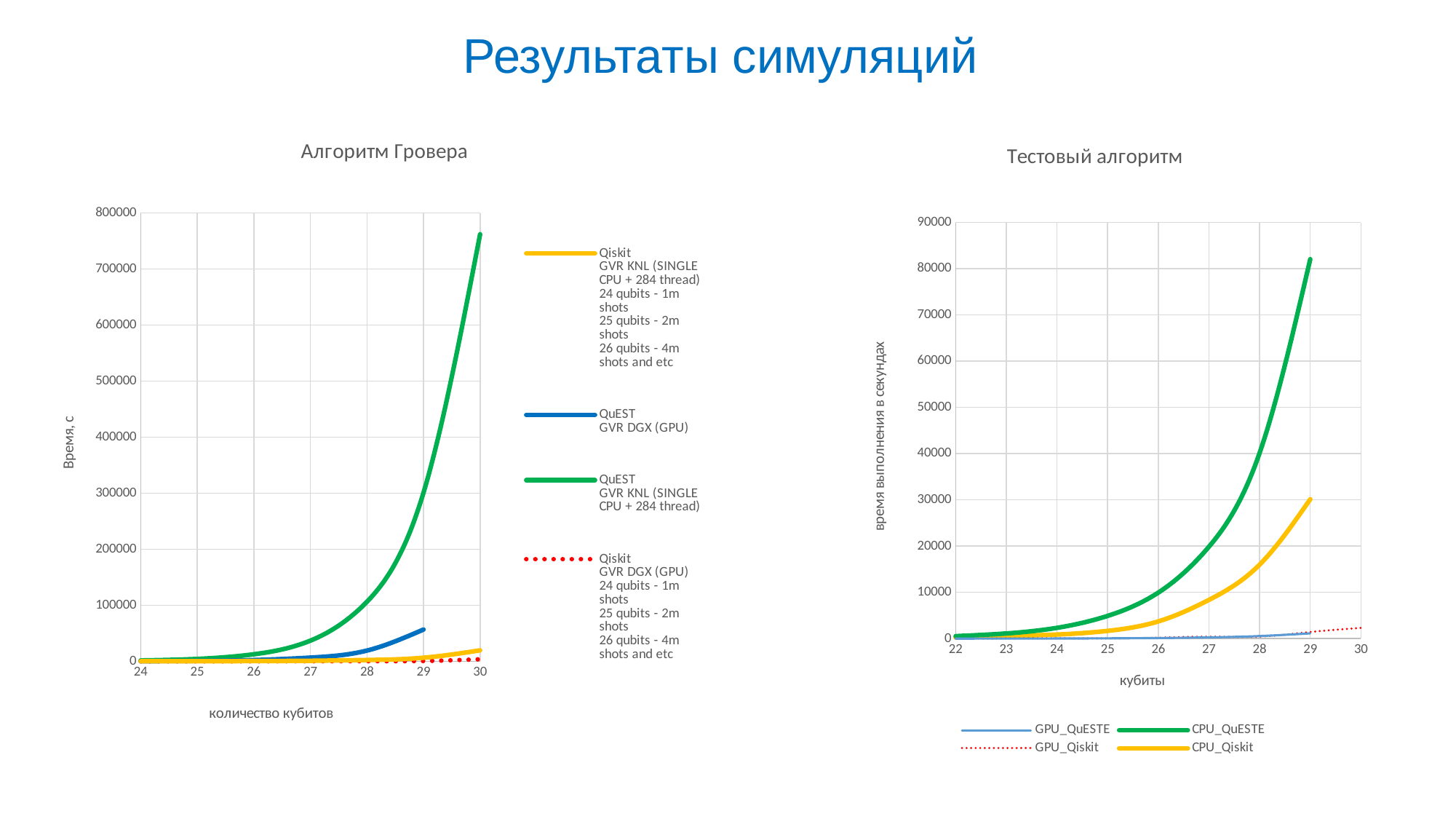
In the 'Тестовый алгоритм' chart, is the value of CPU_QuESTE at 29 qubits greater or less than 70000? greater What is the label of the y axis of the 'Тестовый алгоритм' chart? время выполнения в секундах How many series does the legend of the 'Алгоритм Гровера' chart list? 4 How many series does the legend of the 'Тестовый алгоритм' chart list? 4 In the 'Тестовый алгоритм' chart, is the value of CPU_Qiskit at 29 qubits greater or less than 20000? greater In the 'Тестовый алгоритм' chart, does the CPU_QuESTE series rise or fall as the number of qubits increases? rises In the 'Алгоритм Гровера' chart, is the value of the QuEST GVR KNL series at 30 qubits greater or less than 700000? greater What kind of chart is the 'Тестовый алгоритм' chart on the right? line chart In the 'Тестовый алгоритм' chart, which is larger at 29 qubits: CPU_QuESTE or CPU_Qiskit? CPU_QuESTE What kind of chart is the 'Алгоритм Гровера' chart on the left? line chart In the 'Тестовый алгоритм' chart, which series reaches the highest value? CPU_QuESTE In the 'Алгоритм Гровера' chart, which series reaches the highest value at 30 qubits? QuEST GVR KNL (SINGLE CPU + 284 thread)